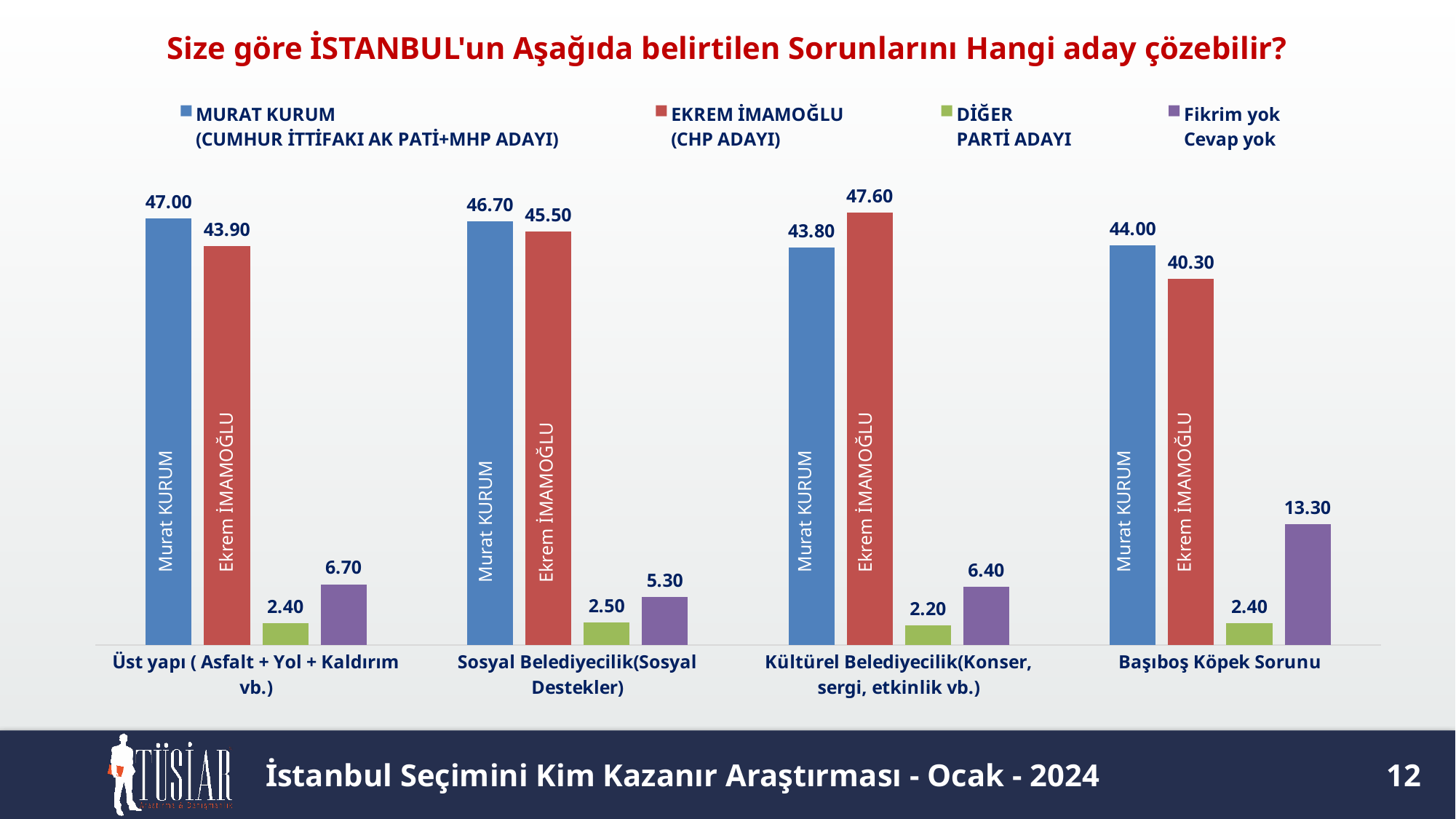
How many problem categories are shown on the x axis? 4 Which colour represents Ekrem İmamoğlu (CHP Adayı) in the chart? Red What value is shown for 'Fikrim yok Cevap yok' in the 'Sosyal Belediyecilik(Sosyal Destekler)' category? 5.30 How many series does the legend list? 4 What value is shown for Murat Kurum in the 'Üst yapı ( Asfalt + Yol + Kaldırım vb.)' category? 47.00 In the 'Kültürel Belediyecilik(Konser, sergi, etkinlik vb.)' category, who has the higher value, Murat Kurum or Ekrem İmamoğlu? Ekrem İmamoğlu What is the difference between the 'Fikrim yok Cevap yok' values for 'Başıboş Köpek Sorunu' and 'Üst yapı ( Asfalt + Yol + Kaldırım vb.)'? 6.60 In which category does 'Diğer Parti Adayı' have its lowest value? Kültürel Belediyecilik(Konser, sergi, etkinlik vb.) What is the difference between Murat Kurum and Ekrem İmamoğlu in the 'Başıboş Köpek Sorunu' category? 3.70 What kind of chart is shown on the slide? Bar chart In which category does Ekrem İmamoğlu have his highest value? Kültürel Belediyecilik(Konser, sergi, etkinlik vb.) What value is shown for Ekrem İmamoğlu in the 'Başıboş Köpek Sorunu' category? 40.30